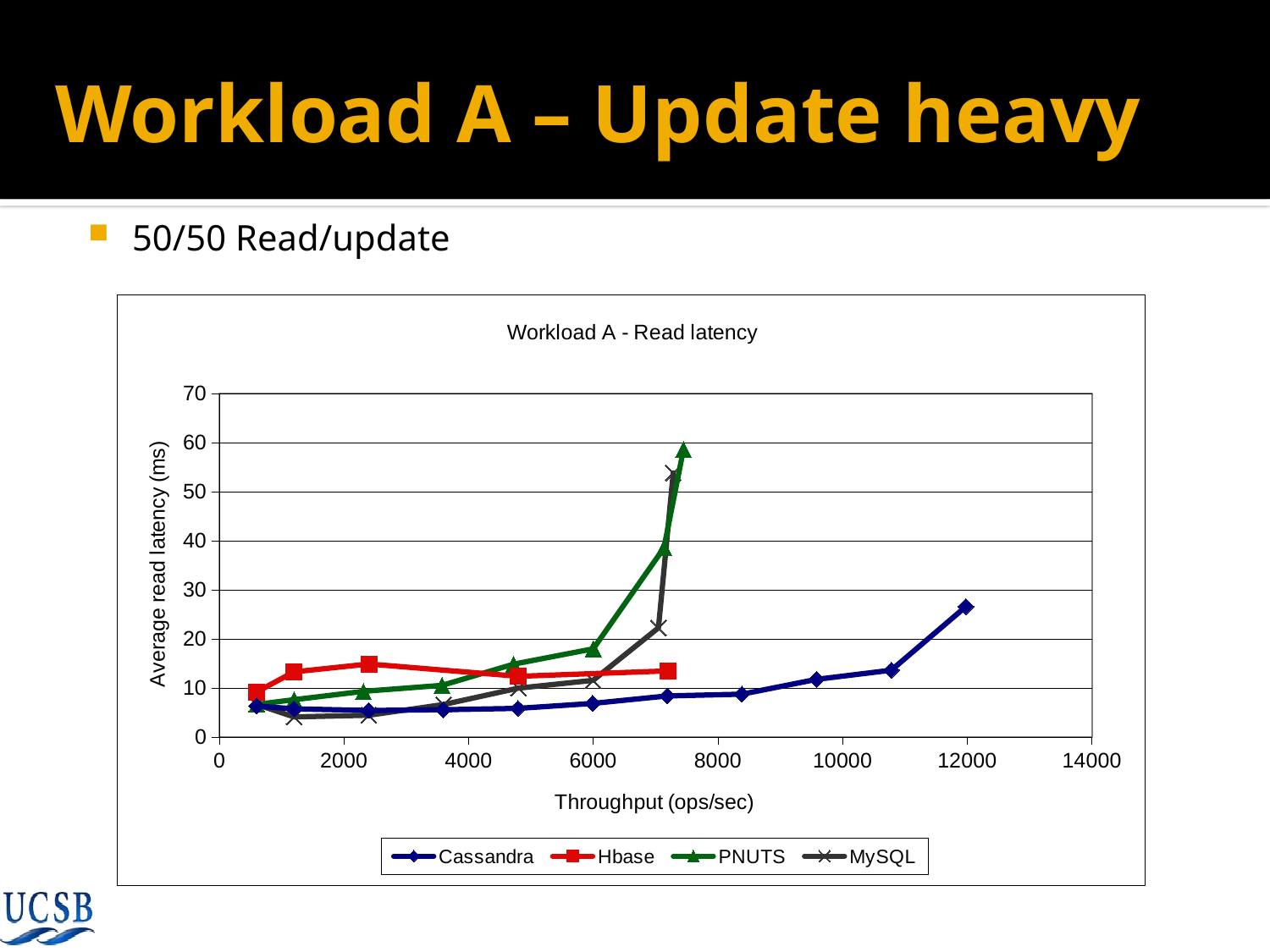
What is the label of the y axis? Average read latency (ms) At a throughput of about 6000 ops/sec, which has the higher read latency, PNUTS or Cassandra? PNUTS Which series reaches the highest average read latency? PNUTS Does the read latency for Cassandra rise or fall as throughput increases? rise Is the highest read latency reached by MySQL greater or less than 40? greater Is the highest read latency reached by Cassandra greater or less than 20? greater Is the highest read latency reached by PNUTS greater or less than 50? greater What is the title of the chart? Workload A - Read latency What kind of chart is shown on the slide? line chart Which series reaches the highest throughput? Cassandra How many series does the legend list? 4